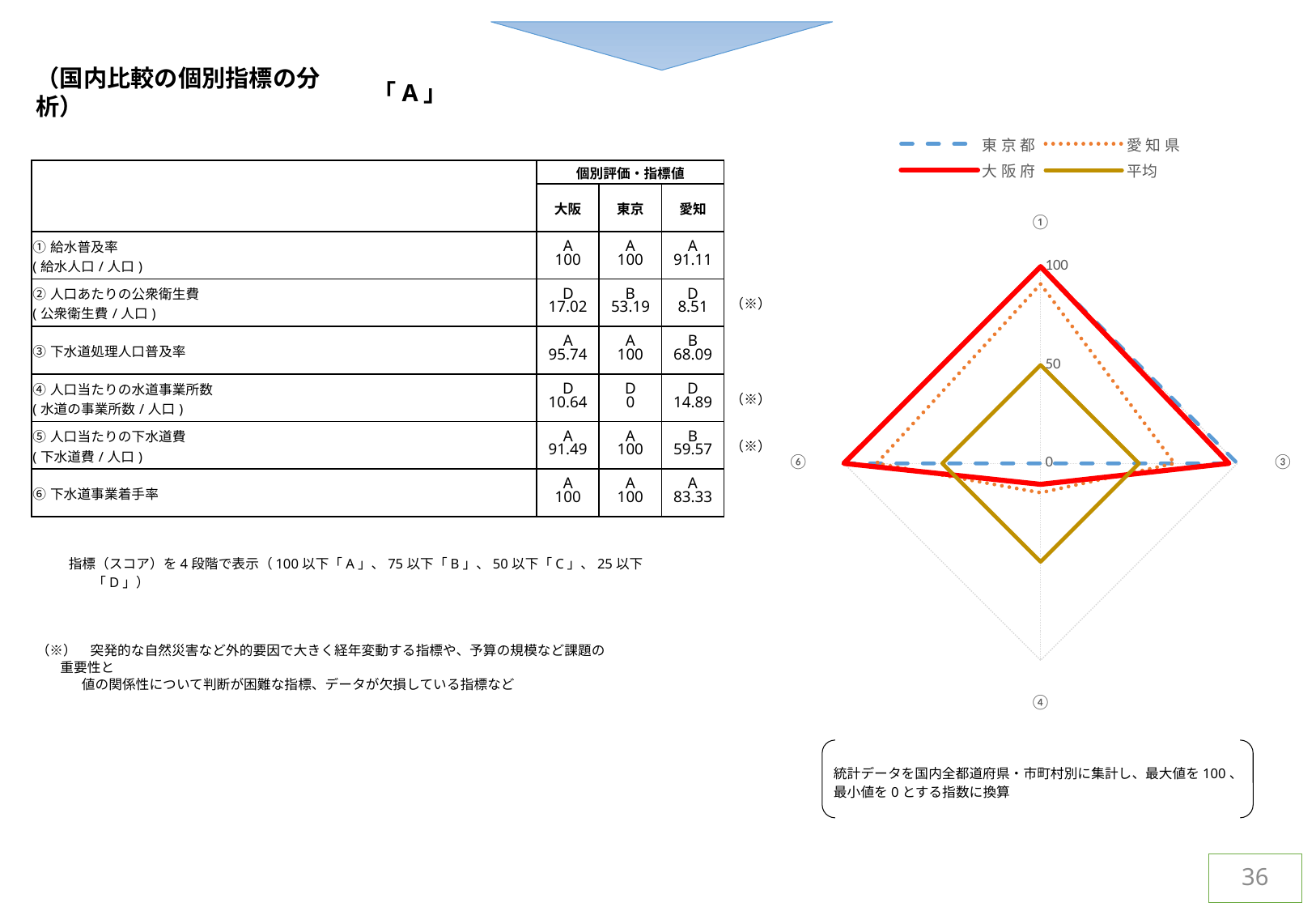
Which series in the radar chart is drawn as a solid red line? 大阪府 Which series in the radar chart is drawn as a blue dashed line? 東京都 In the radar chart, which series has the highest value on axis ④? 平均 In the radar chart, is the value of 東京都 on axis ⑥ greater or less than 50? greater In the radar chart, is the value of 愛知県 on axis ③ greater or less than 50? greater In the radar chart, which series has the lowest value on axis ⑥? 平均 How many series does the legend of the radar chart list? 4 In the radar chart, on axis ①, which is larger: 大阪府 or 平均? 大阪府 In the radar chart, is the value of 大阪府 on axis ① greater or less than 50? greater How many axes (categories) does the radar chart have? 4 What kind of chart is shown on the right of the slide? radar chart